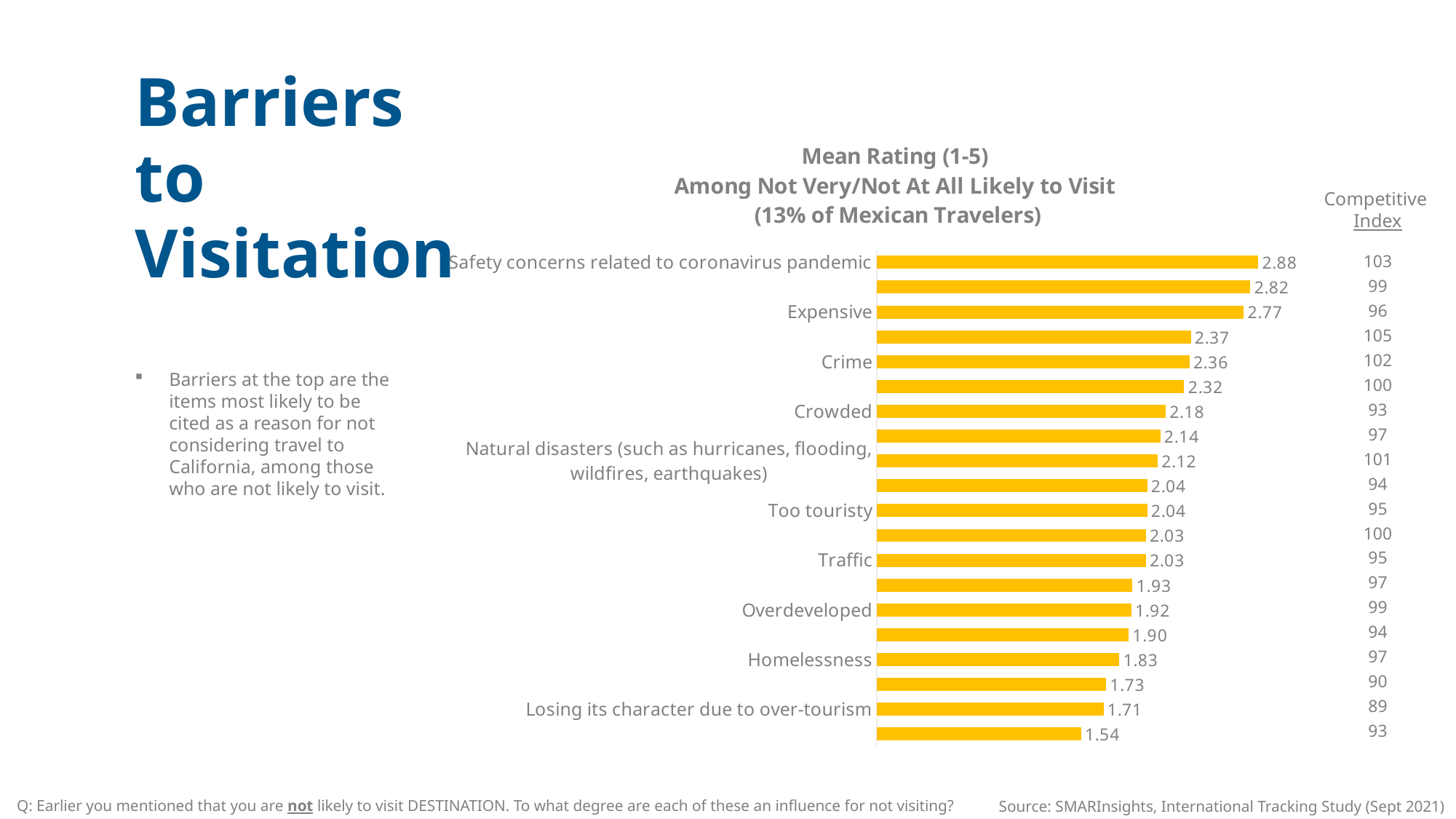
What is the Competitive Index value shown for Expensive? 96 What type of chart is shown on the slide? Bar chart How many bars are plotted on the chart? 20 What is the mean rating for Expensive? 2.77 What is the difference between the mean ratings for Safety concerns related to coronavirus pandemic and Expensive? 0.11 Which labeled barrier has the highest mean rating? Safety concerns related to coronavirus pandemic What is the mean rating for Safety concerns related to coronavirus pandemic? 2.88 Which has a higher mean rating, Crowded or Homelessness? Crowded What is the mean rating for Crime? 2.36 What is the mean rating for Losing its character due to over-tourism? 1.71 What is the lowest mean rating shown on the chart? 1.54 What is the mean rating for Homelessness? 1.83